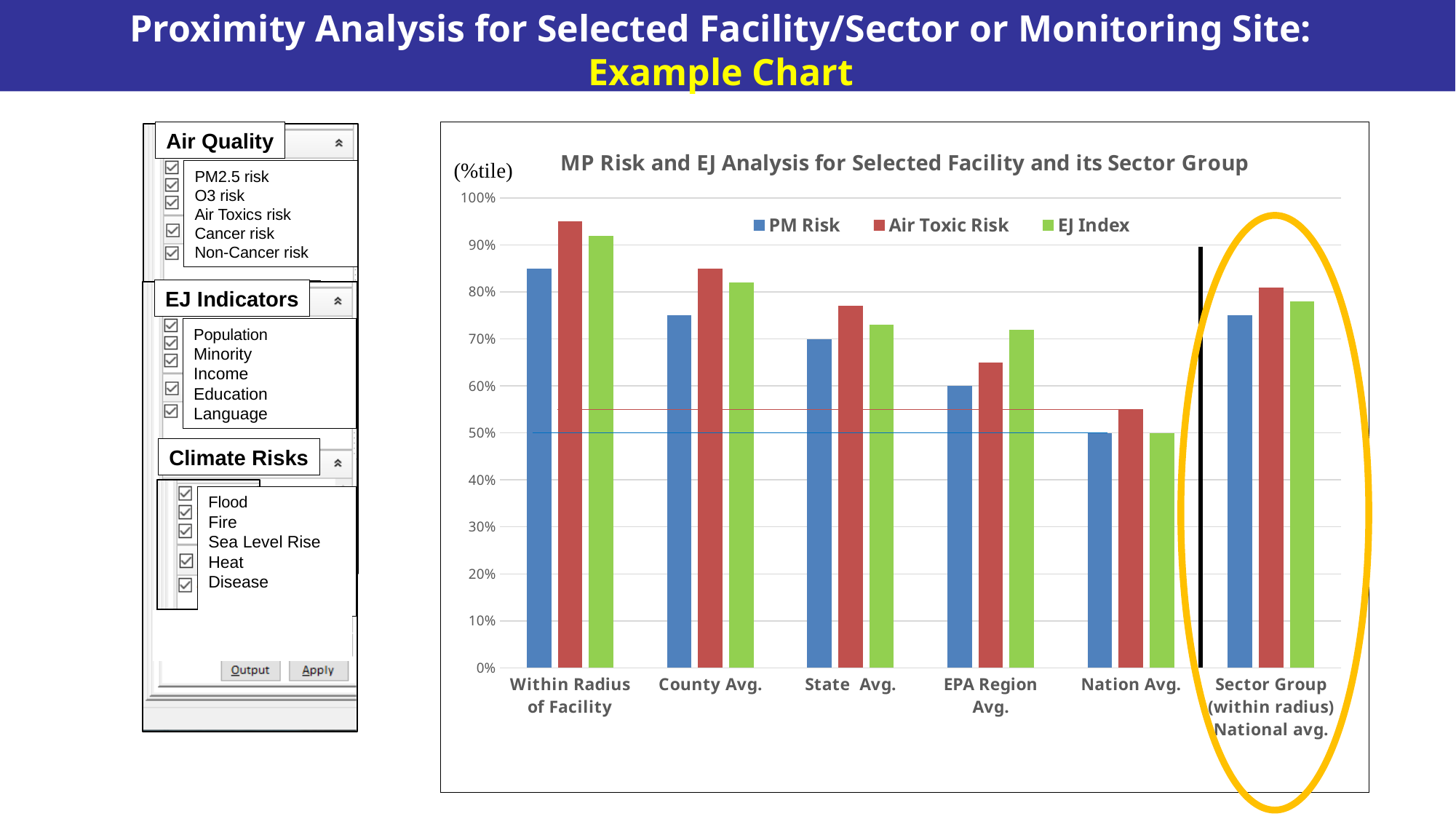
What type of chart is shown on the slide? bar chart What is the PM Risk value for Nation Avg.? 50% Which category has the highest Air Toxic Risk value? Within Radius of Facility Which category has the lowest PM Risk value? Nation Avg. How many series does the chart legend list? 3 How many categories are shown along the x axis of the chart? 6 Does the PM Risk value rise or fall from Within Radius of Facility to Nation Avg.? fall Is the Air Toxic Risk value for Within Radius of Facility greater or less than 90%? greater What is the PM Risk value for EPA Region Avg.? 60% What is the PM Risk value for State Avg.? 70% Which is larger, the PM Risk value for Within Radius of Facility or for County Avg.? Within Radius of Facility Is the Air Toxic Risk value for Nation Avg. greater or less than 60%? less